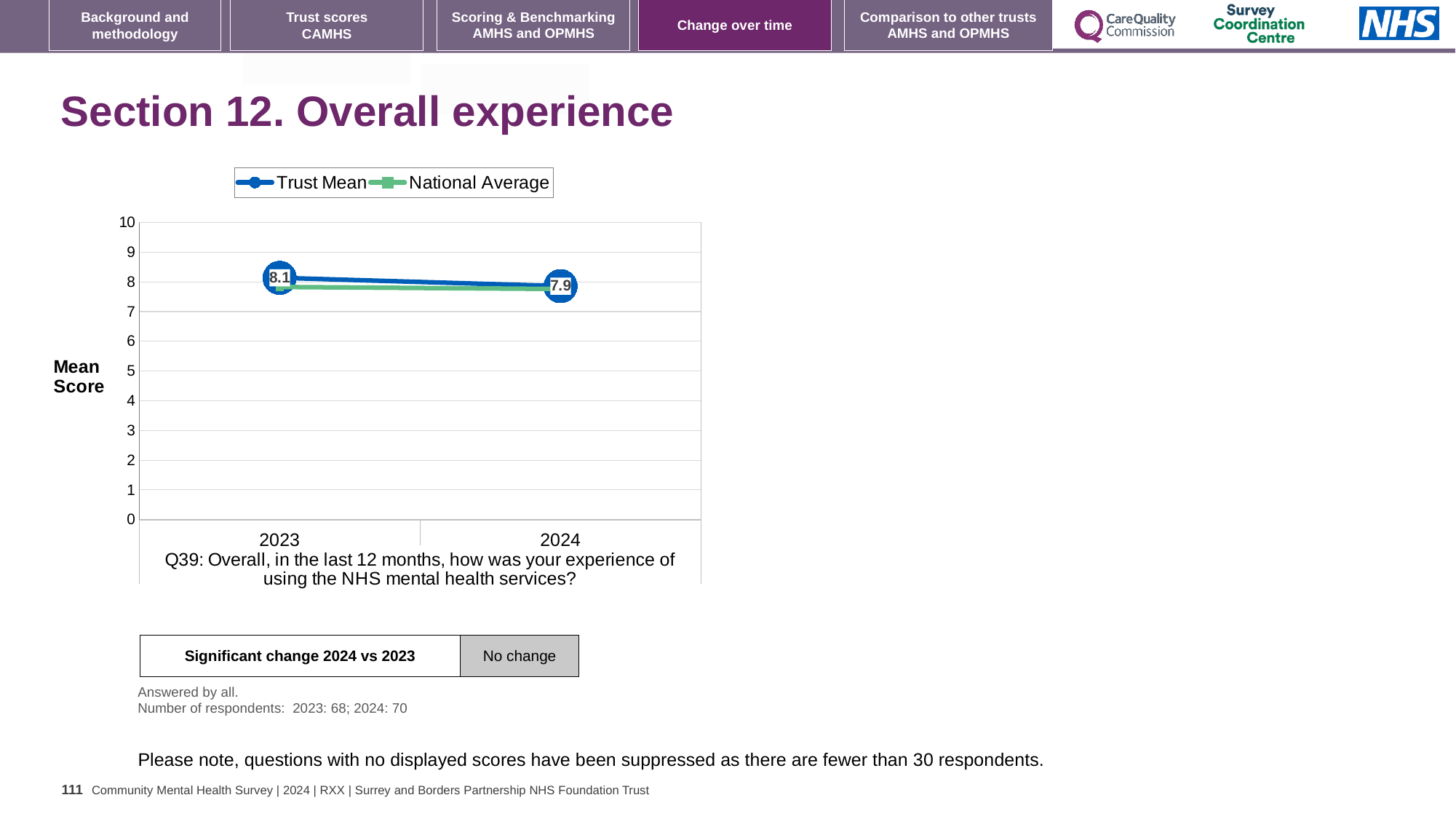
How many series does the legend list? 2 By how much did the Trust Mean score change from 2023 to 2024? 0.2 What is the label on the y axis of the chart? Mean Score What is the Trust Mean score for 2023? 8.1 Does the Trust Mean score rise or fall from 2023 to 2024? fall How many years are plotted on the x axis? 2 What is the Trust Mean score for 2024? 7.9 Is the National Average value for 2024 greater or less than 5? greater What kind of chart is shown on the slide? line chart Which year has the higher Trust Mean score, 2023 or 2024? 2023 Is the National Average value for 2023 greater or less than 9? less In which year is the Trust Mean score highest? 2023